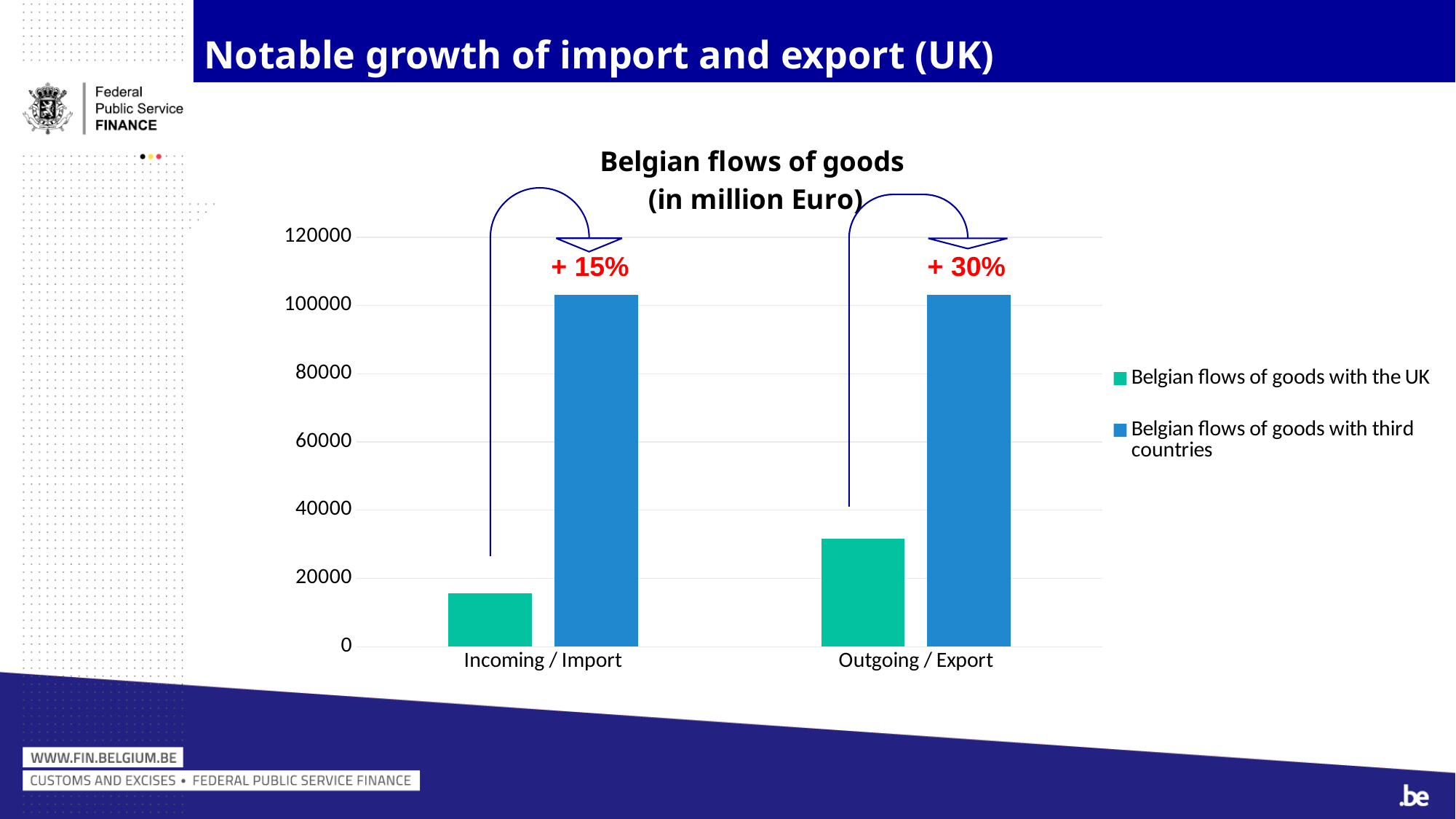
Is the value for Belgian flows of goods with the UK for Outgoing / Export greater or less than 20000? greater How many series does the chart legend list? 2 Which is larger for Belgian flows of goods with the UK: Incoming / Import or Outgoing / Export? Outgoing / Export What percentage growth is annotated above the Outgoing / Export bars? + 30% Is the value for Belgian flows of goods with the UK for Incoming / Import greater or less than 20000? less For Incoming / Import, which series has the higher value? Belgian flows of goods with third countries How many categories are shown on the x axis of the chart? 2 Is the value for Belgian flows of goods with third countries for Outgoing / Export greater or less than 120000? less What is the title of the chart? Belgian flows of goods (in million Euro) Which bar in the chart has the lowest value? Belgian flows of goods with the UK, Incoming / Import What kind of chart is shown on the slide? bar chart